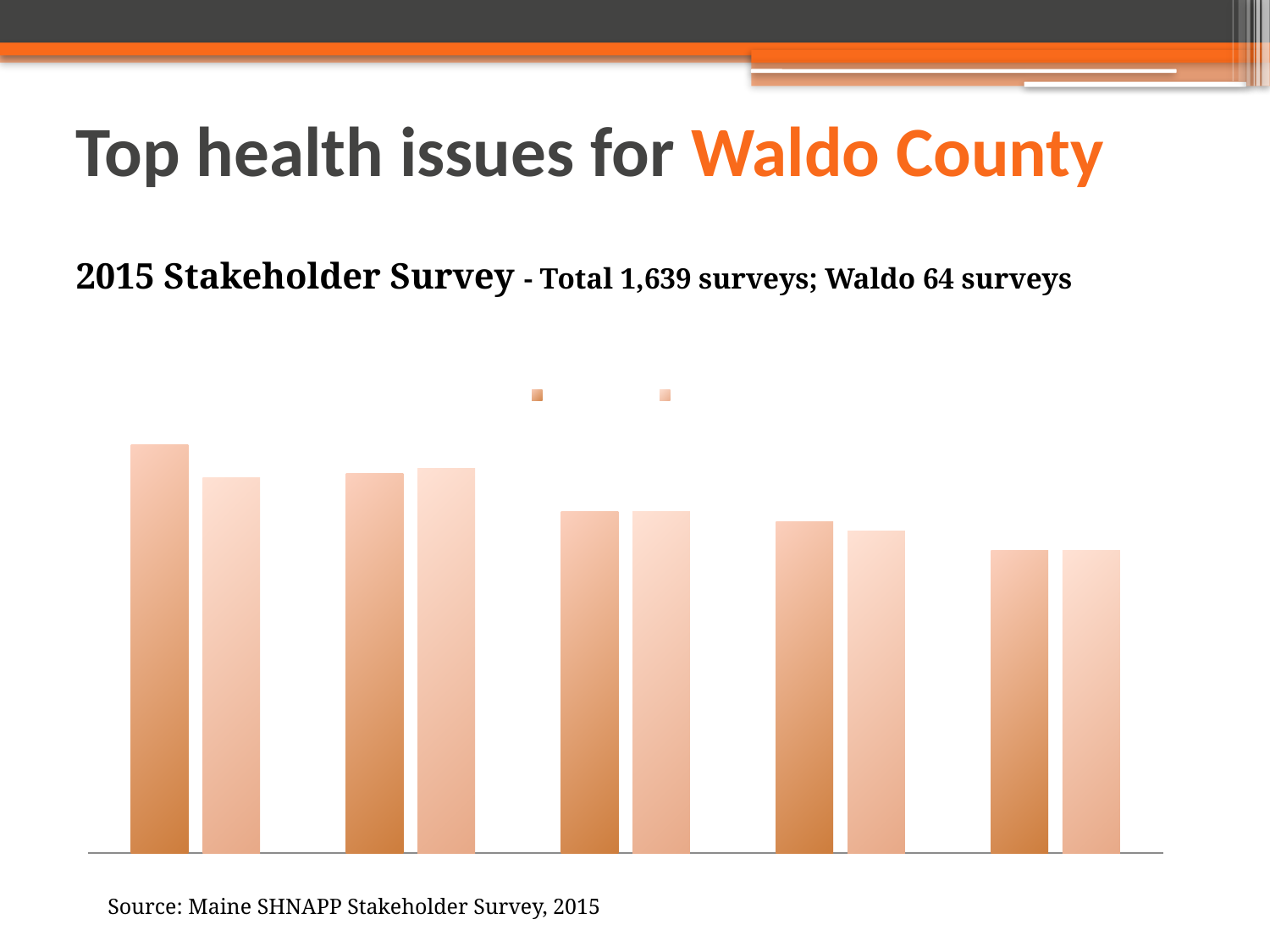
In the leftmost group, is the darker orange bar taller or shorter than the lighter bar? taller How many bars are plotted in total on the chart? 10 How many groups of bars (categories) does the chart show? 5 Do the bar heights generally rise or fall from left to right across the chart? fall Which group of bars is the shortest in the chart? the rightmost group In the second group from the left, is the darker orange bar taller or shorter than the lighter bar? shorter What colours are used for the two series in the chart? dark orange and light orange How many series does the chart's legend list? 2 Which group of bars is the tallest in the chart? the leftmost group What kind of chart is shown on the slide? bar chart